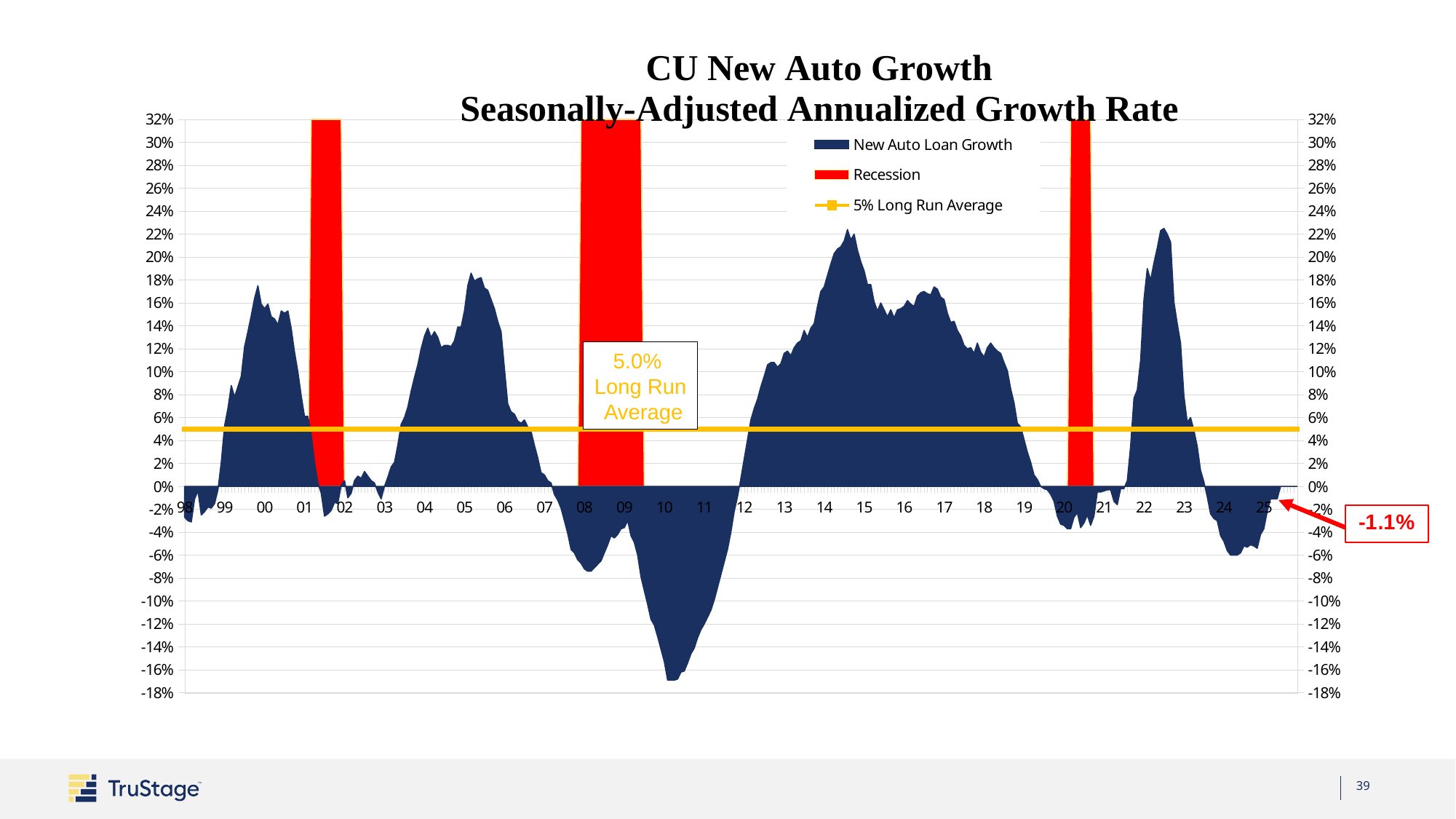
Does New Auto Loan Growth rise or fall from its 2022 peak to 2024? fall What is the most recent value of New Auto Loan Growth labeled on the chart? -1.1% What colour are the recession bars on the chart? red What is the title of the chart? CU New Auto Growth Seasonally-Adjusted Annualized Growth Rate Is the peak value of New Auto Loan Growth in 2022 greater or less than 20%? greater Is the lowest value of New Auto Loan Growth around 2010 greater or less than -10%? less Is the value of New Auto Loan Growth in 2024 greater or less than 0%? less What value is the Long Run Average line set at? 5.0% Which is higher: the peak of New Auto Loan Growth in 2022 or the peak in 2005? 2022 How many recession periods are shaded on the chart? 3 What type of chart is used to show New Auto Loan Growth? area chart How many entries does the legend list? 3